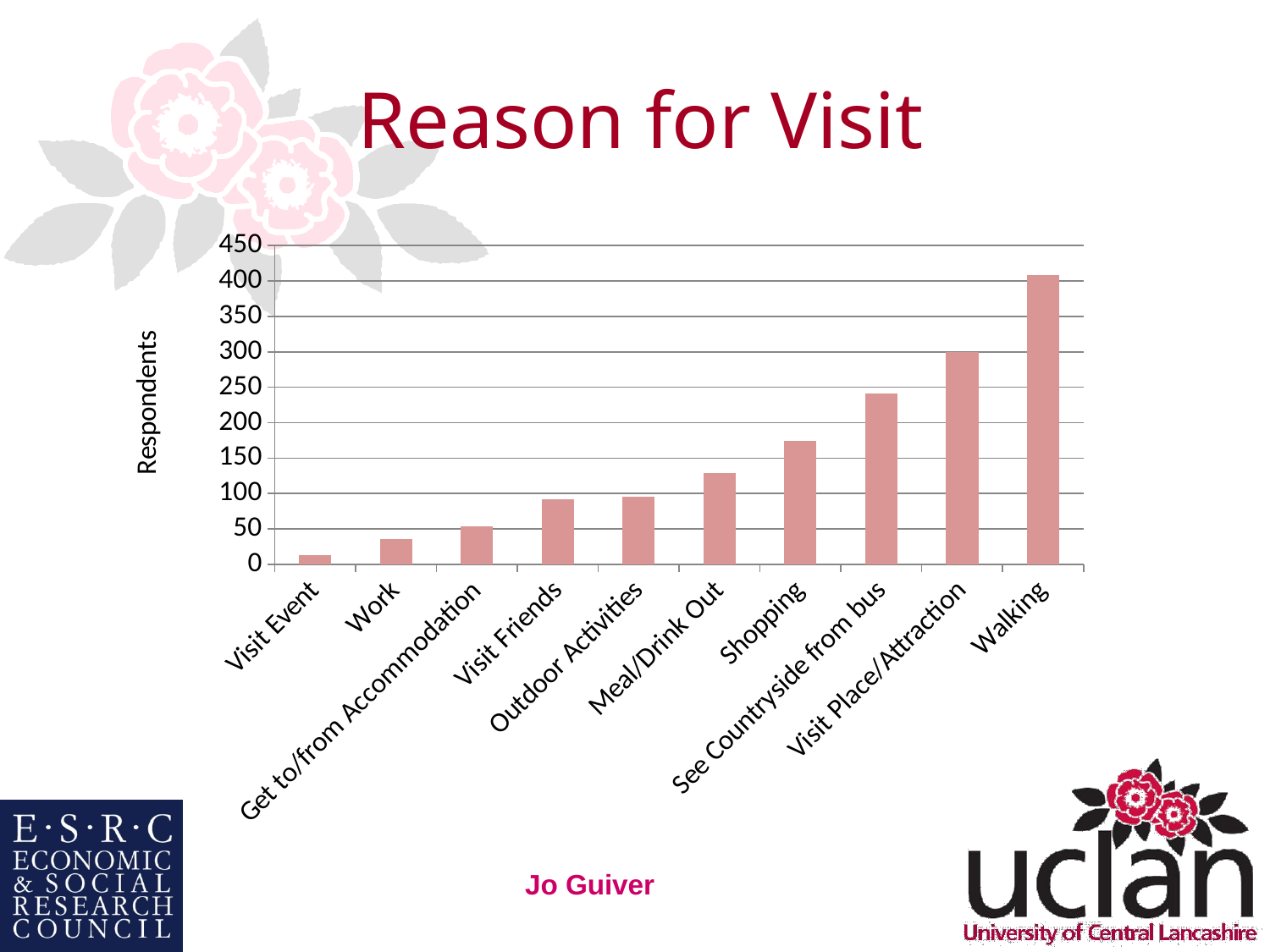
Do the values rise or fall moving from left to right along the x axis? rise What is the label on the vertical axis of the chart? Respondents Is the value for Work greater or less than 50? less Which reason for visit has the highest number of respondents? Walking Which reason for visit has the lowest number of respondents? Visit Event Which has more respondents, Shopping or Visit Friends? Shopping What kind of chart is shown on the slide? bar chart Is the value for Shopping greater or less than 150? greater What is the title of the chart on the slide? Reason for Visit How many categories (reasons for visit) are plotted on the chart? 10 Is the value for See Countryside from bus greater or less than 200? greater